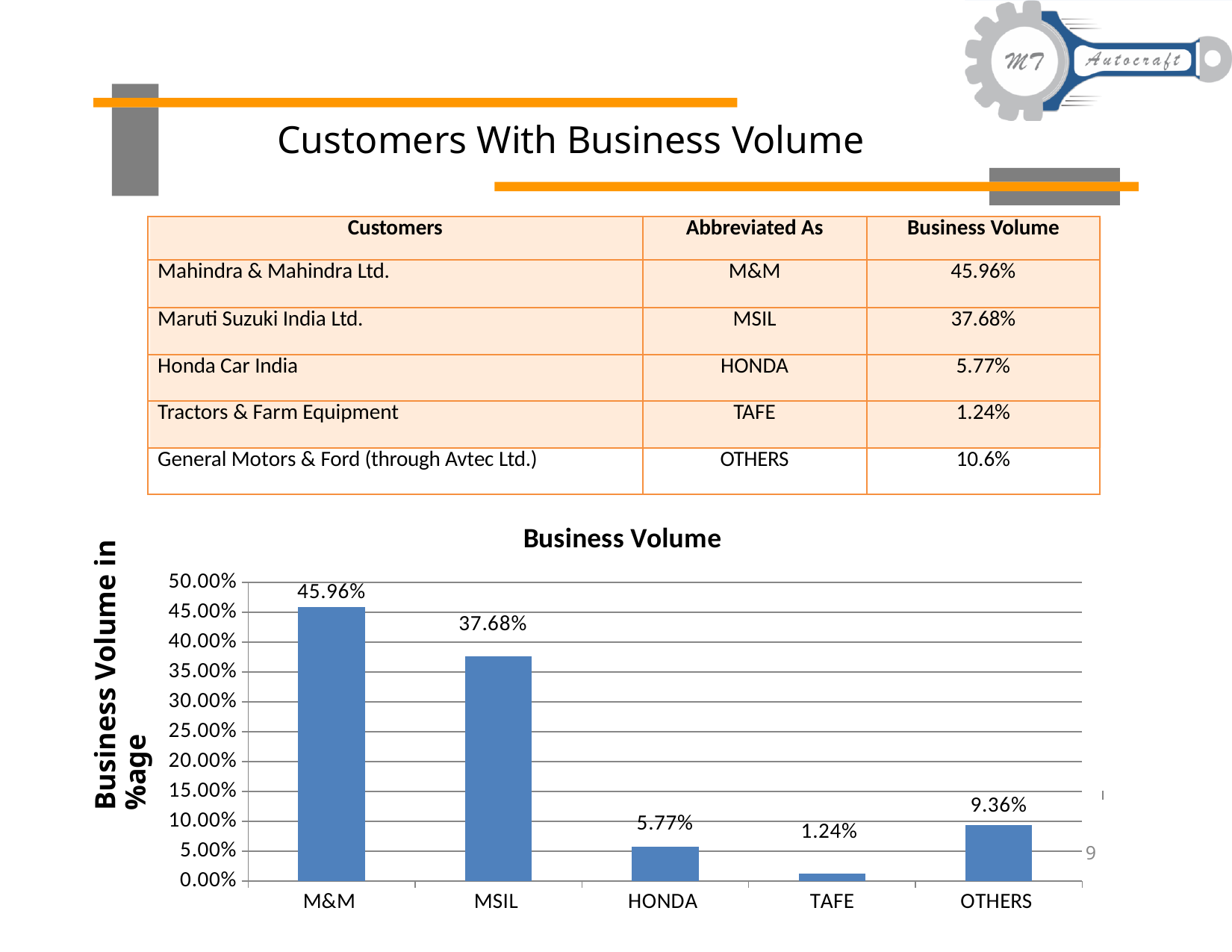
What is the value for TAFE in the Business Volume chart? 1.24% What is the value for OTHERS in the Business Volume chart? 9.36% How many categories are shown on the x axis of the Business Volume chart? 5 What is the value for MSIL in the Business Volume chart? 37.68% Is the value for MSIL in the Business Volume chart greater or less than 40.00%? less Which category has the highest value in the Business Volume chart? M&M What is the value for M&M in the Business Volume chart? 45.96% In the Business Volume chart, which is larger, the value for HONDA or the value for OTHERS? OTHERS What is the difference between the values for M&M and MSIL in the Business Volume chart? 8.28% What kind of chart is the Business Volume chart? bar chart Which category has the lowest value in the Business Volume chart? TAFE What is the y-axis label of the Business Volume chart? Business Volume in %age